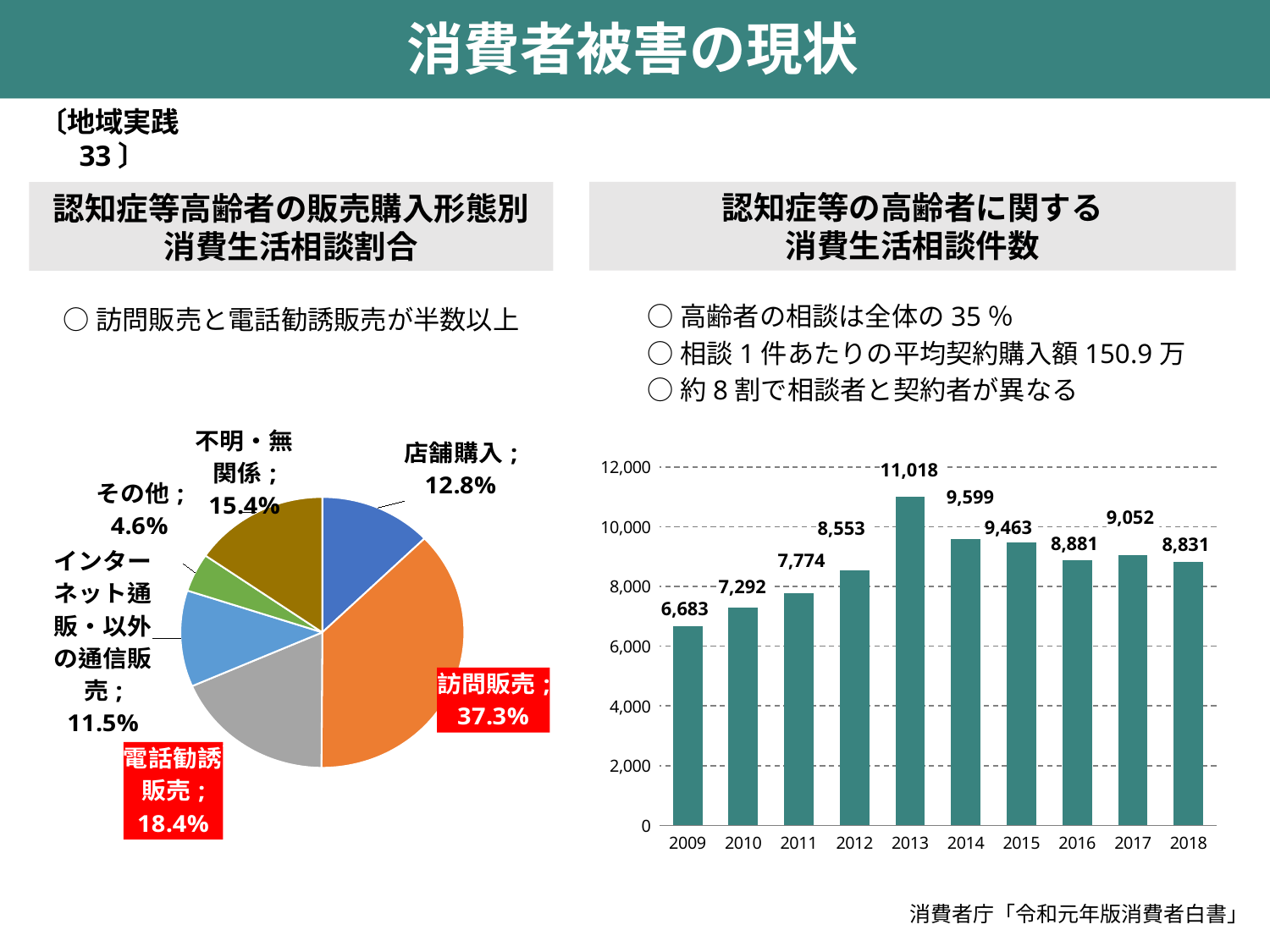
左側の円グラフ「認知症等高齢者の販売購入形態別消費生活相談割合」で、訪問販売の割合はいくつですか？ 37.3% 右側の棒グラフ「認知症等の高齢者に関する消費生活相談件数」で、2009年の値はいくつですか？ 6,683 右側の棒グラフ「認知症等の高齢者に関する消費生活相談件数」で、最も値が大きい年はどれですか？ 2013 右側の棒グラフ「認知症等の高齢者に関する消費生活相談件数」には、何年分の棒がありますか？ 10 左側の円グラフ「認知症等高齢者の販売購入形態別消費生活相談割合」で、最も割合が小さい区分はどれですか？ その他 右側の棒グラフ「認知症等の高齢者に関する消費生活相談件数」で、2013年と2018年の値の差はいくつですか？ 2,187 右側の棒グラフ「認知症等の高齢者に関する消費生活相談件数」で、2014年と2017年ではどちらの値が大きいですか？ 2014 左側の円グラフ「認知症等高齢者の販売購入形態別消費生活相談割合」で、電話勧誘販売の割合はいくつですか？ 18.4% 右側の棒グラフ「認知症等の高齢者に関する消費生活相談件数」で、2013年の値はいくつですか？ 11,018 右側の棒グラフ「認知症等の高齢者に関する消費生活相談件数」で、最も値が小さい年はどれですか？ 2009 左側のグラフ「認知症等高齢者の販売購入形態別消費生活相談割合」はどの種類のグラフですか？ 円グラフ 右側の棒グラフ「認知症等の高齢者に関する消費生活相談件数」で、2009年から2013年にかけて値は増加していますか、減少していますか？ 増加